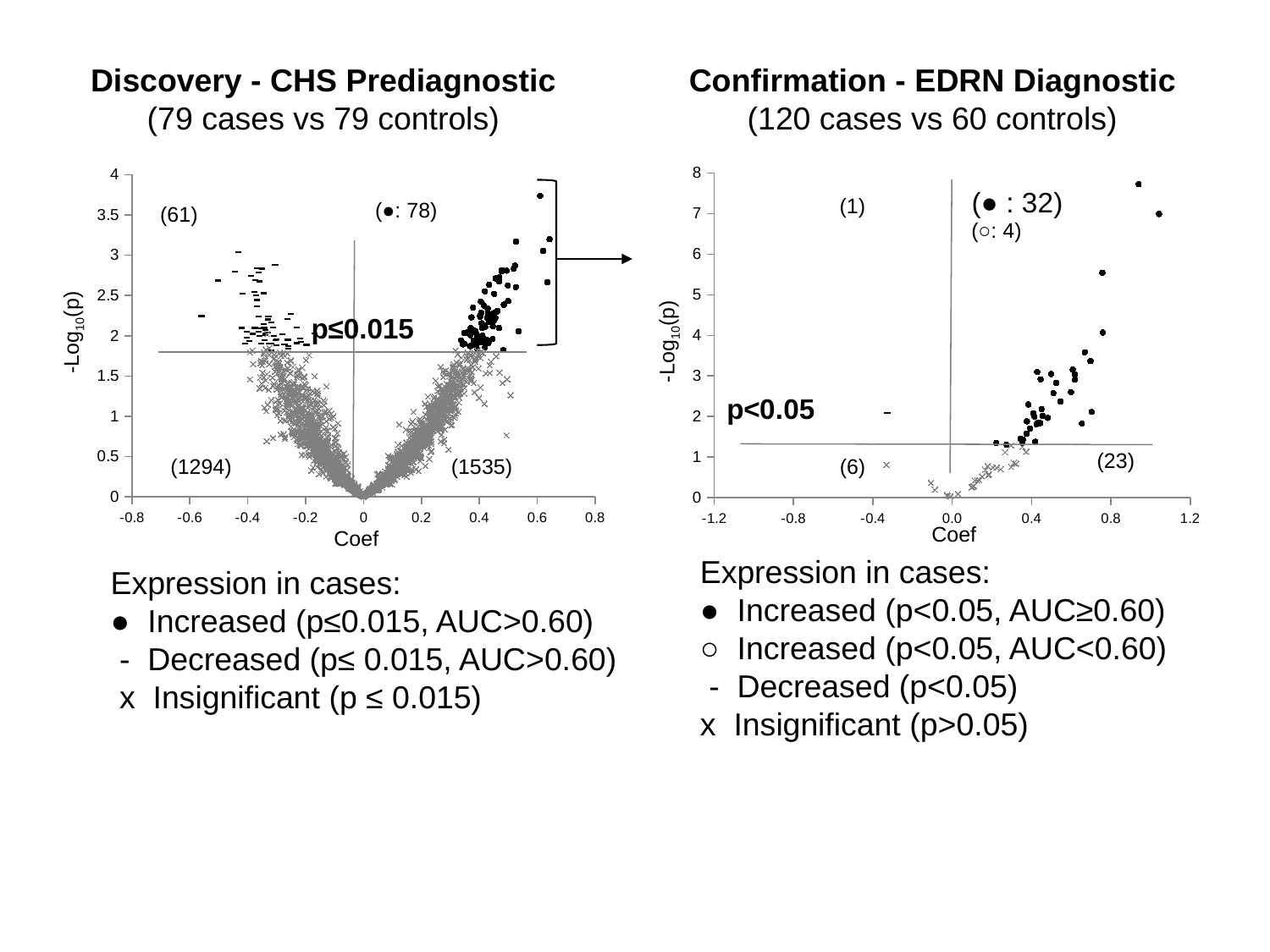
Which chart reports more increased (●) markers, Discovery - CHS Prediagnostic or Confirmation - EDRN Diagnostic? Discovery - CHS Prediagnostic In the Confirmation - EDRN Diagnostic chart, what count is printed in the lower-right region? 23 What p-value threshold is printed on the Discovery - CHS Prediagnostic chart? p≤0.015 In the Discovery - CHS Prediagnostic chart, what count is printed in the lower-right region? 1535 In the Confirmation - EDRN Diagnostic chart, how many markers are labelled with the open circle (○)? 4 What kind of chart is the Discovery - CHS Prediagnostic chart? Scatter plot In the Discovery - CHS Prediagnostic chart, how many markers are labelled as increased (●)? 78 In the Confirmation - EDRN Diagnostic chart, how many markers are labelled with the filled circle (●)? 32 In the Confirmation - EDRN Diagnostic chart, is the -Log10(p) value of the highest point greater or less than 7? greater What is the difference between the number of increased (●) markers in the Discovery chart (78) and in the Confirmation chart (32)? 46 In the Discovery - CHS Prediagnostic chart, what count is printed in the upper-left region for decreased markers? 61 In the Discovery - CHS Prediagnostic chart, what count is printed in the lower-left region? 1294